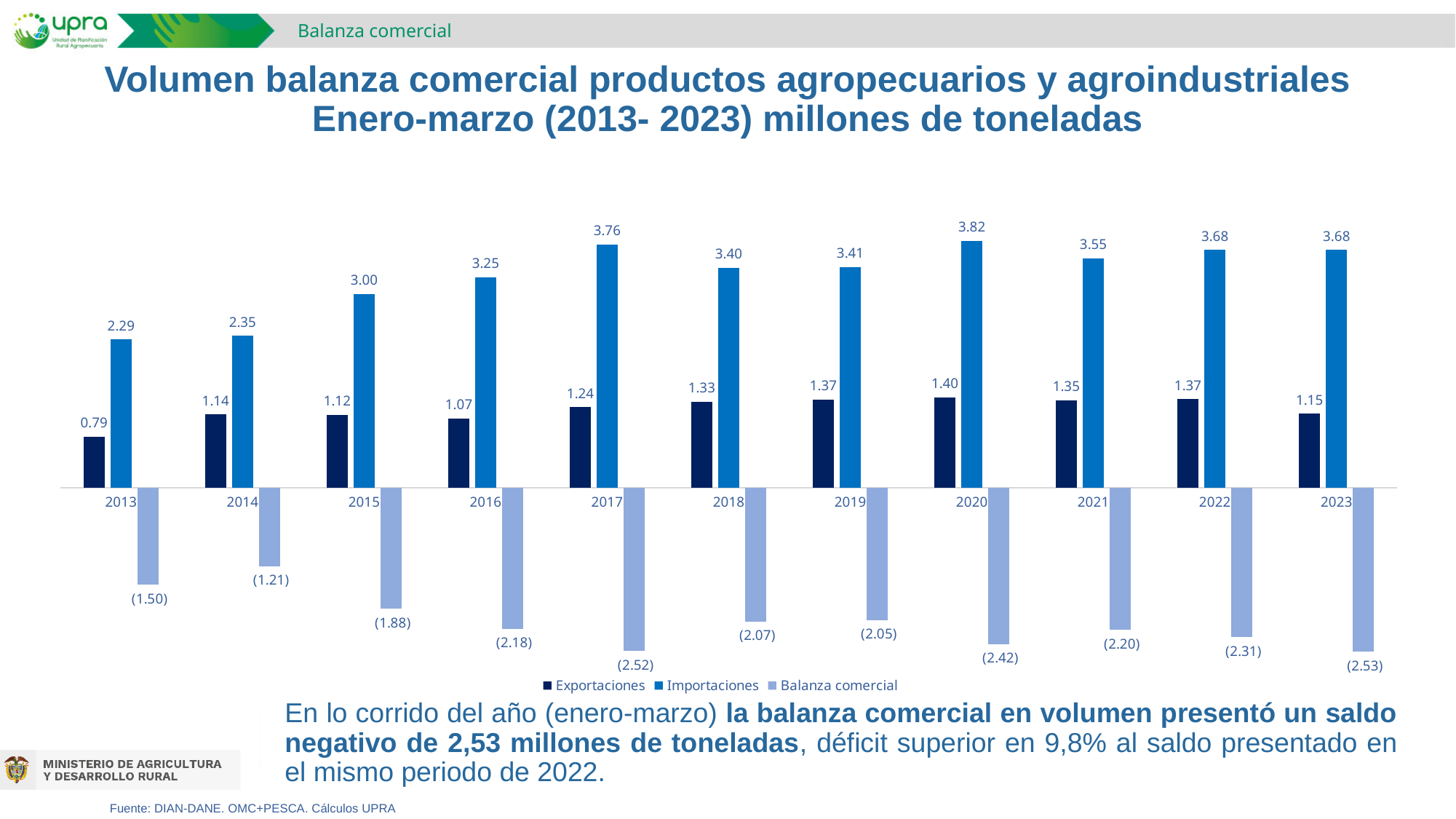
What is the difference between Importaciones and Exportaciones in 2023? 2.53 What is the value of Exportaciones for 2013? 0.79 What is the value of Importaciones for 2020? 3.82 In which year is Importaciones highest? 2020 What kind of chart is shown on the slide? Bar chart Do the Importaciones values rise or fall from 2013 to 2017? Rise Which is larger, Importaciones in 2017 or Importaciones in 2018? Importaciones in 2017 How many years are shown on the x axis? 11 In which year is the Balanza comercial bar the smallest in magnitude (closest to zero)? 2014 What is the value of Balanza comercial for 2023? (2.53) In which year is Exportaciones lowest? 2013 How many series does the legend list? 3